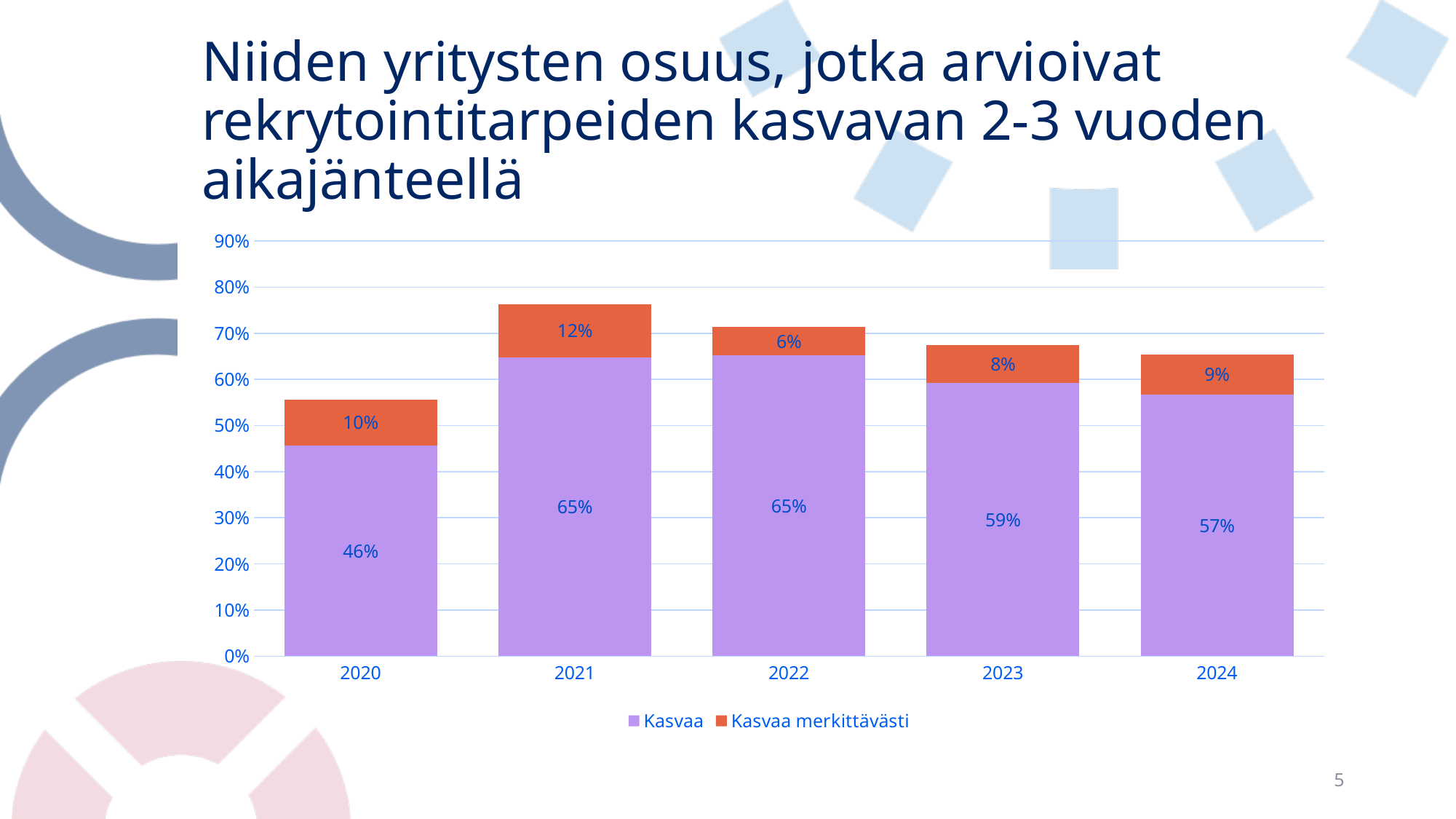
What is the value for Kasvaa in 2024? 57% What is the total of the stacked bar for 2021? 77% Which is larger, the Kasvaa merkittävästi value for 2020 or for 2023? 2020 What is the difference between the Kasvaa values for 2023 and 2024? 2% What is the value for Kasvaa in 2020? 46% Which year has the lowest value for Kasvaa? 2020 What is the total of the stacked bar for 2020? 56% How many series does the legend list? 2 Which year has the lowest value for Kasvaa merkittävästi? 2022 How many years are shown on the x axis? 5 Which year has the highest value for Kasvaa merkittävästi? 2021 What is the value for Kasvaa merkittävästi in 2021? 12%